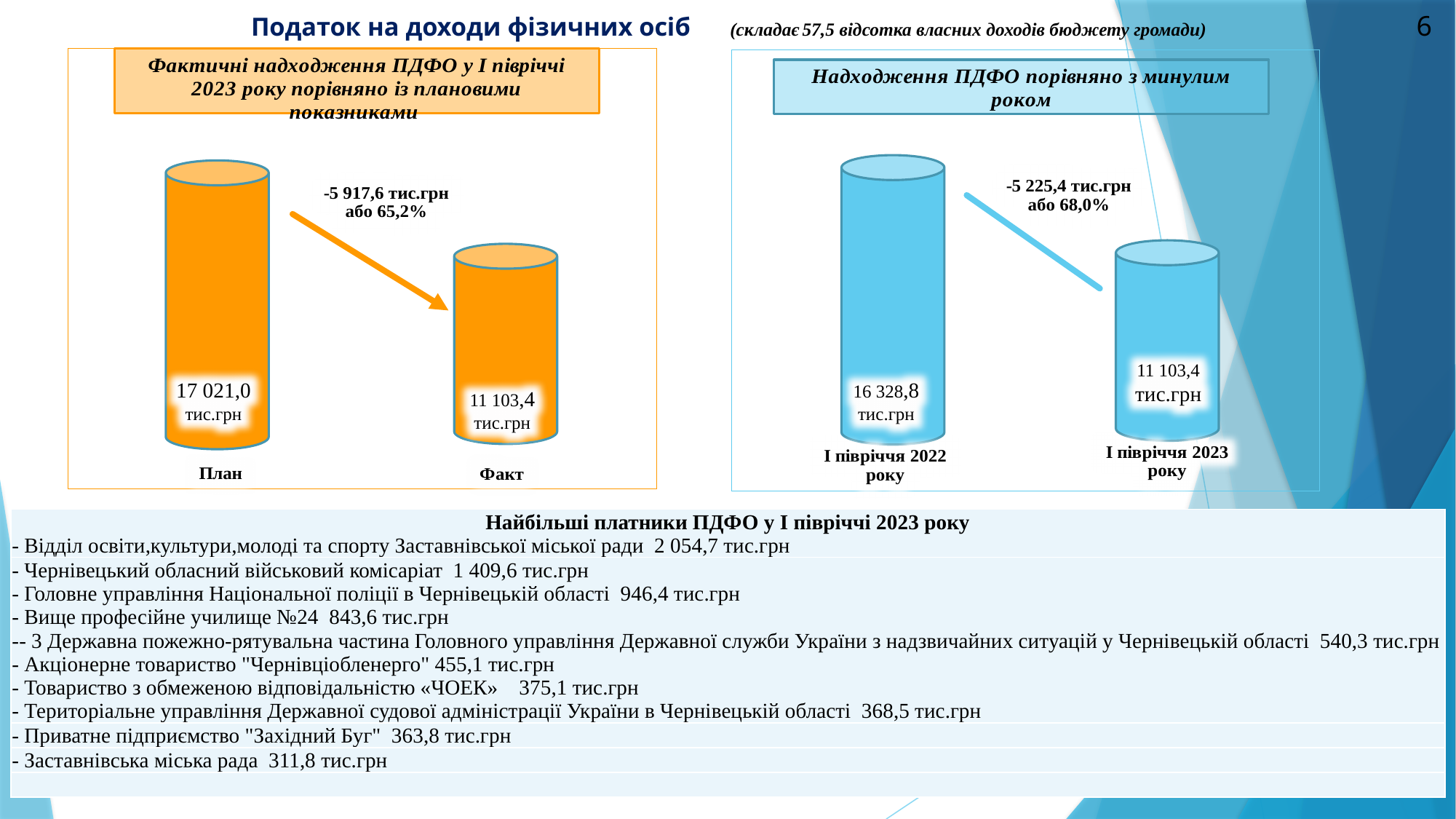
In the right chart, which period has the lower value? І півріччя 2023 року In the left chart, which category has the higher value, План or Факт? План In the left chart (Фактичні надходження ПДФО у І півріччі 2023 року порівняно із плановими показниками), what is the value for План? 17 021,0 тис.грн In the right chart (Надходження ПДФО порівняно з минулим роком), what is the value for І півріччя 2022 року? 16 328,8 тис.грн In the right chart, what is the value for І півріччя 2023 року? 11 103,4 тис.грн How many categories are shown in the left chart? 2 In the right chart, what is the difference between І півріччя 2022 року and І півріччя 2023 року as printed on the slide? -5 225,4 тис.грн In the left chart, what percentage of the plan does the actual figure represent, as printed on the slide? 65,2% In the left chart, what is the value for Факт? 11 103,4 тис.грн In the right chart, do the values rise or fall from І півріччя 2022 року to І півріччя 2023 року? fall In the left chart, what is the difference between План and Факт as printed on the slide? -5 917,6 тис.грн What type of chart is the right chart? bar chart